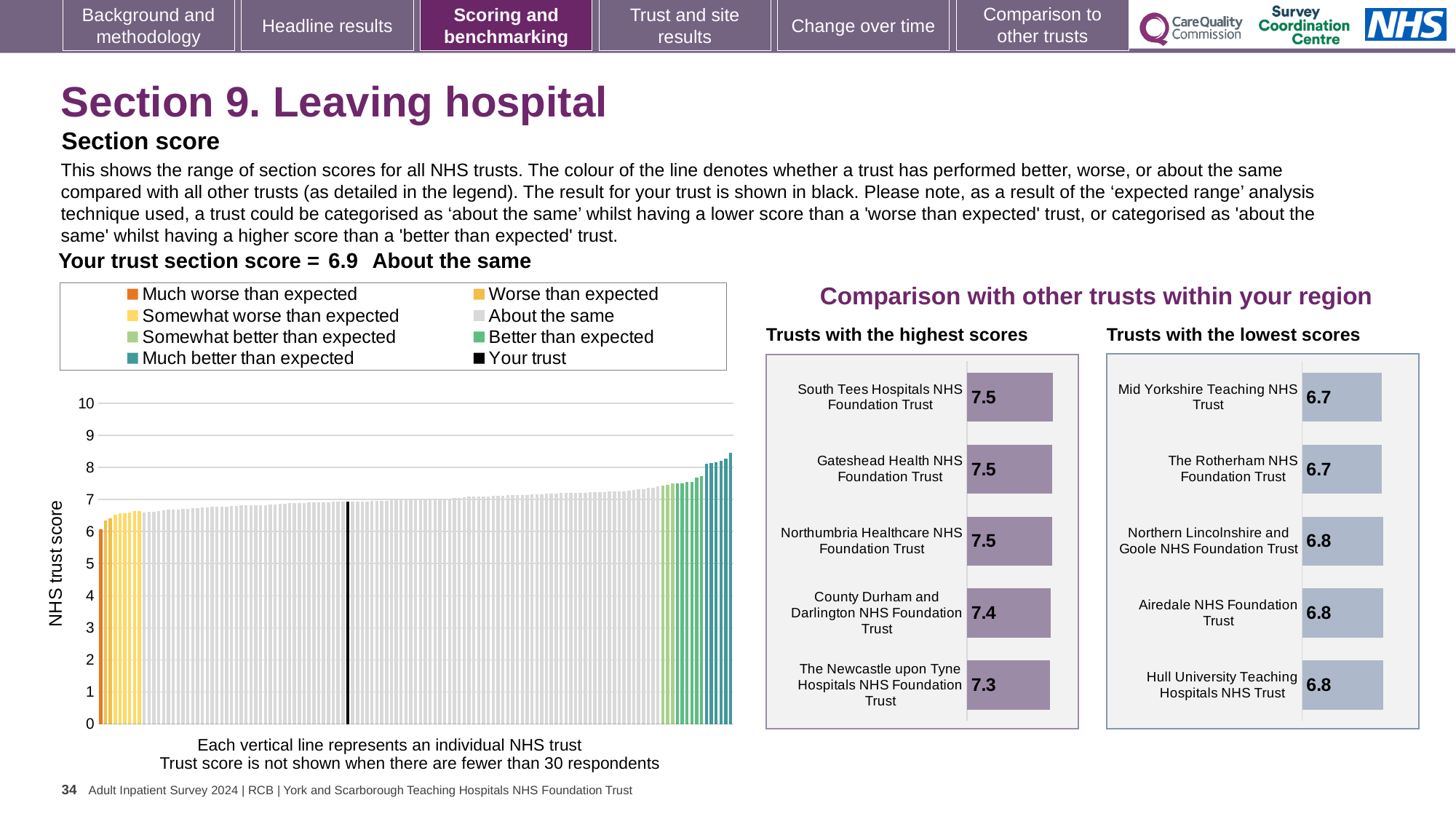
What kind of chart is the large chart on the left showing NHS trust scores? bar chart In the large chart on the left, is the highest trust score greater or less than 9? less In the large chart on the left, what is the section score for your trust? 6.9 In the 'Trusts with the highest scores' chart, which trust has the lowest score? The Newcastle upon Tyne Hospitals NHS Foundation Trust In the 'Trusts with the highest scores' chart, what is the score for County Durham and Darlington NHS Foundation Trust? 7.4 In the large chart on the left, do the trust scores rise or fall from left to right? rise In the 'Trusts with the lowest scores' chart, which has the larger score: Northern Lincolnshire and Goole NHS Foundation Trust or The Rotherham NHS Foundation Trust? Northern Lincolnshire and Goole NHS Foundation Trust How many entries does the legend above the large chart on the left list? 8 How many trusts are shown in the 'Trusts with the lowest scores' chart? 5 In the 'Trusts with the highest scores' chart, what is the difference between the scores of South Tees Hospitals NHS Foundation Trust and The Newcastle upon Tyne Hospitals NHS Foundation Trust? 0.2 In the 'Trusts with the lowest scores' chart, what is the score for Mid Yorkshire Teaching NHS Trust? 6.7 What is the y-axis label of the large chart on the left? NHS trust score